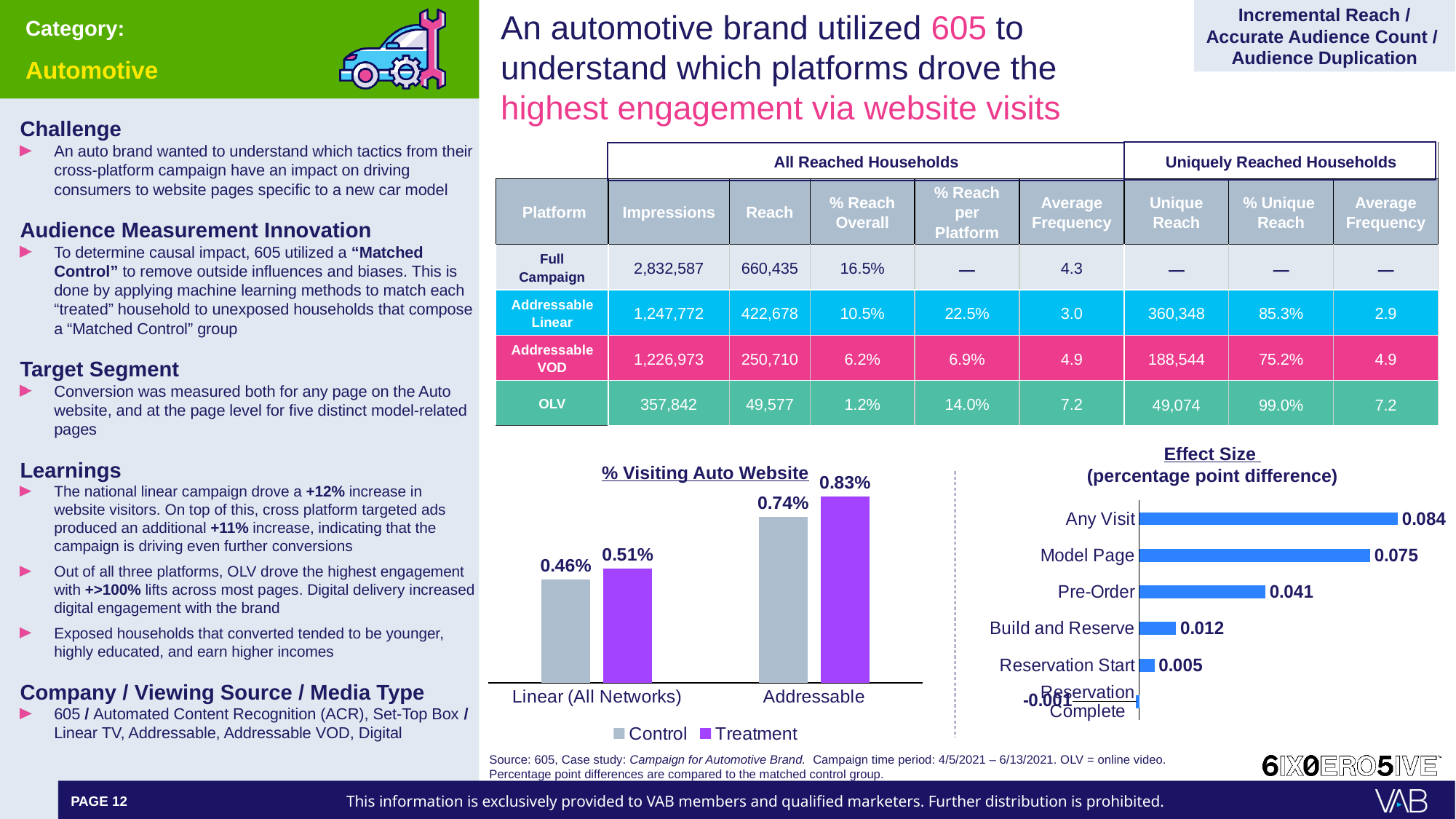
In the 'Effect Size' chart, what is the value for Model Page? 0.075 How many categories are shown in the 'Effect Size' chart? 6 In the 'Effect Size' chart, which category has the highest value? Any Visit In the 'Effect Size' chart, what is the difference between the values for Any Visit and Pre-Order? 0.043 In the '% Visiting Auto Website' chart, what is the difference between the Treatment and Control values for Addressable? 0.09% In the 'Effect Size' chart, which category has the lowest value? Reservation Complete In the '% Visiting Auto Website' chart, what is the Control value for Linear (All Networks)? 0.46% In the 'Effect Size' chart, what is the value for Reservation Start? 0.005 In the '% Visiting Auto Website' chart, which is larger for Linear (All Networks): Control or Treatment? Treatment In the '% Visiting Auto Website' chart, what is the Treatment value for Addressable? 0.83% What kind of chart is the '% Visiting Auto Website' chart? Bar chart How many series does the legend of the '% Visiting Auto Website' chart list? 2